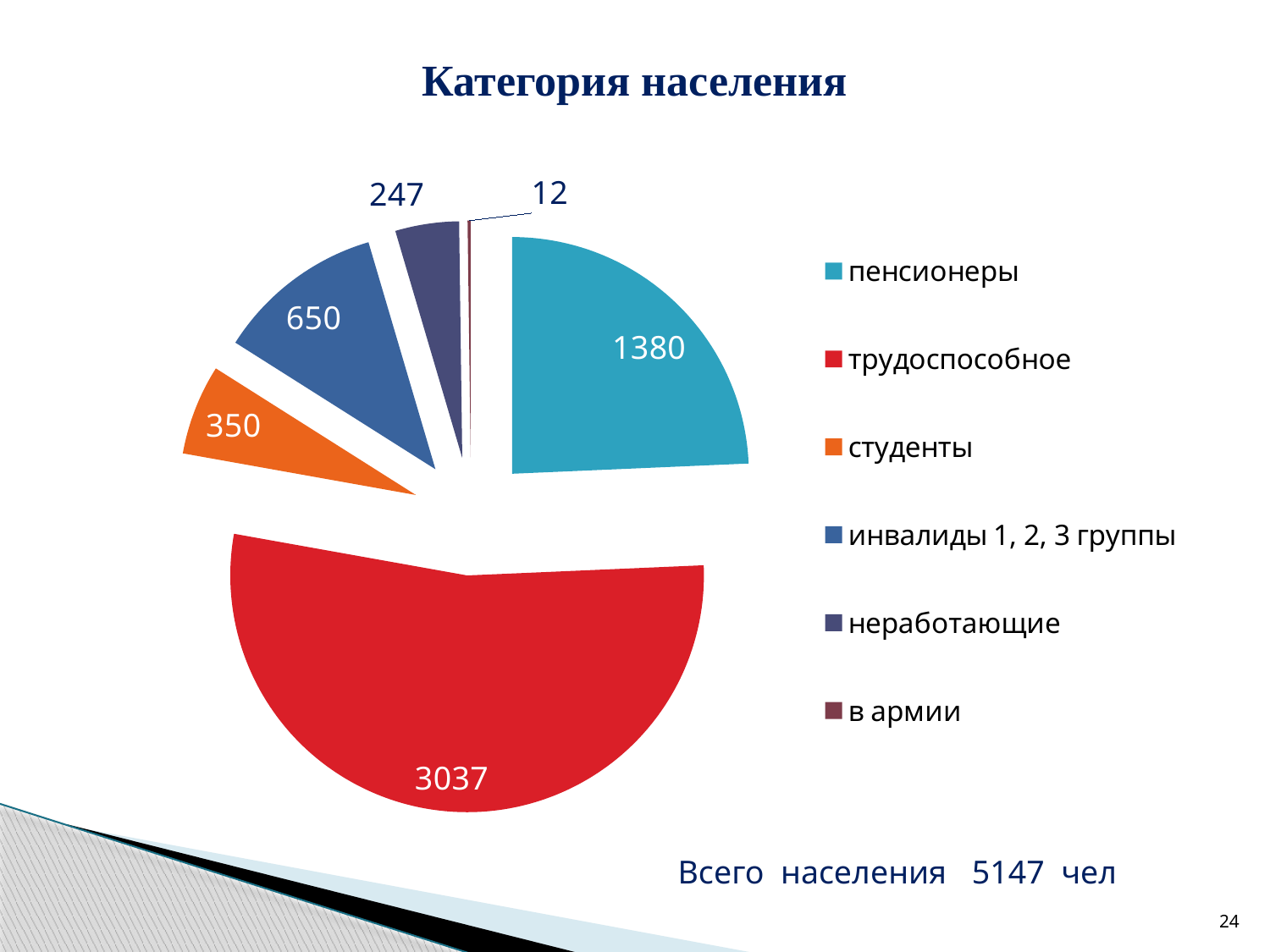
Which category has the smallest slice? в армии What is the difference between the values for трудоспособное and пенсионеры? 1657 What kind of chart is shown on the slide? pie chart How many categories does the pie chart have? 6 What is the value for инвалиды 1, 2, 3 группы? 650 Which category has the largest slice? трудоспособное What is the value for пенсионеры? 1380 What is the value for студенты? 350 What is the title of the chart? Категория населения What is the value for трудоспособное? 3037 What is the value for в армии? 12 Which is larger, the value for инвалиды 1, 2, 3 группы or the value for студенты? инвалиды 1, 2, 3 группы